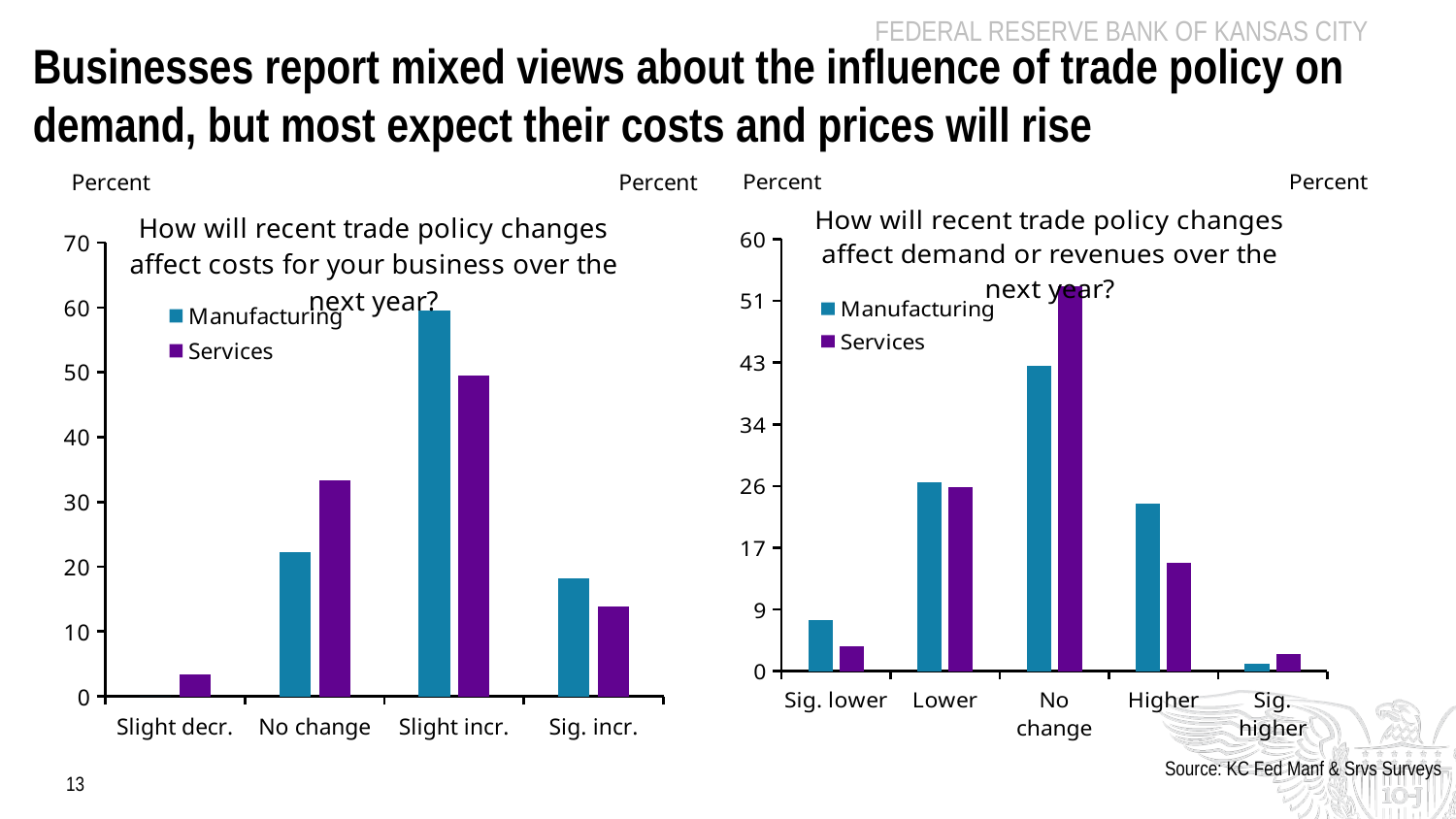
On the right chart about demand or revenues, which is larger for Higher: Manufacturing or Services? Manufacturing How many categories are shown on the x axis of the left chart about costs? 4 On the left chart about costs, which is larger for No change: Manufacturing or Services? Services On the left chart about costs, which category has the highest Manufacturing value? Slight incr. What colour represents the Services series on both charts? Purple What kind of chart is the left chart about how trade policy changes affect costs? Bar chart On the right chart about demand or revenues, which category has the highest Services value? No change How many categories are shown on the x axis of the right chart about demand or revenues? 5 How many series does the legend list on the right chart about demand or revenues? 2 On the left chart about costs, which category has the lowest Services value? Slight decr. On the left chart about costs, is the Manufacturing value for Slight incr. greater or less than 50? greater On the right chart about demand or revenues, is the Manufacturing value for No change greater or less than 34? greater